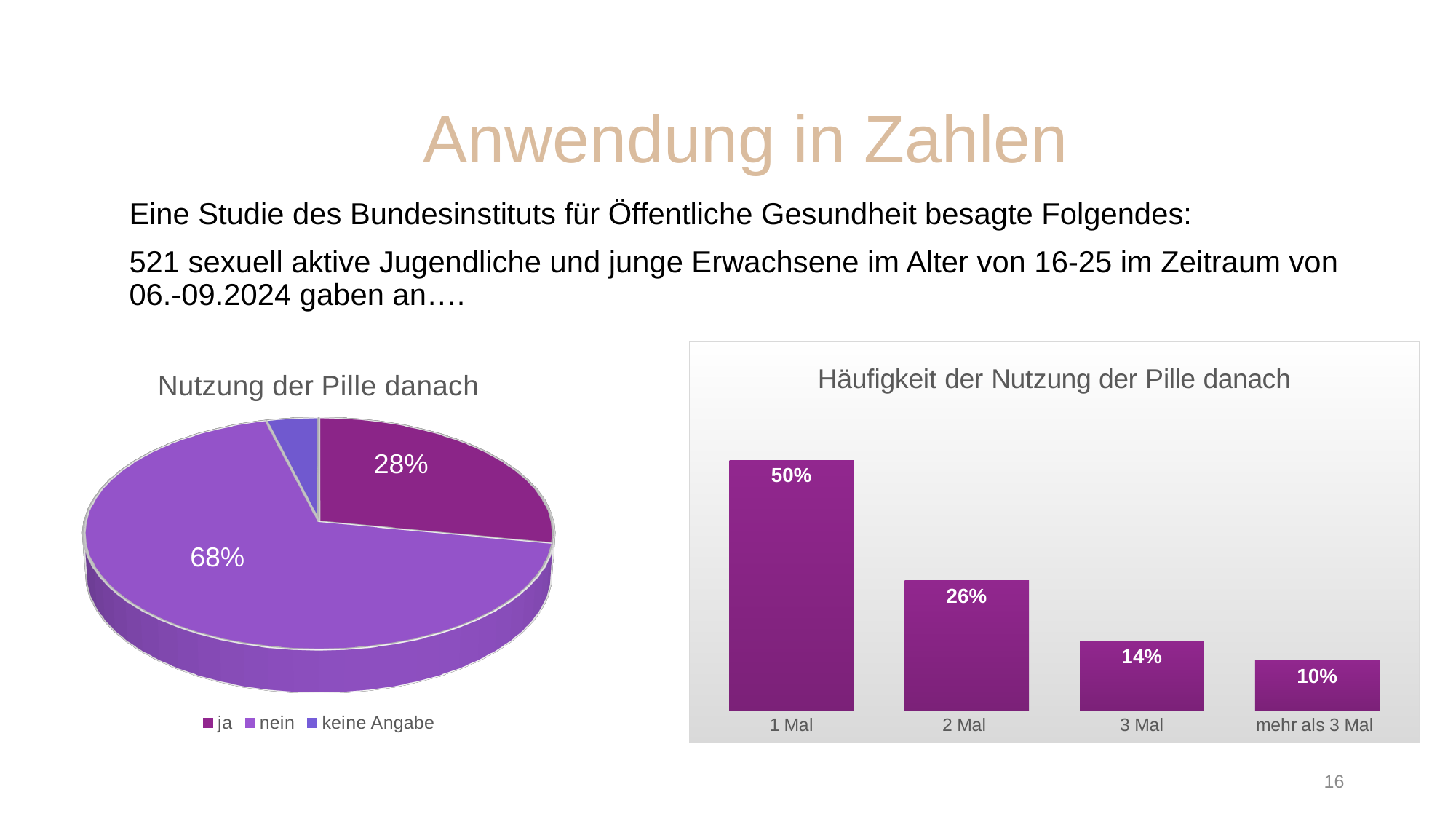
In the bar chart 'Häufigkeit der Nutzung der Pille danach', what is the difference in percentage points between '2 Mal' and '3 Mal'? 12 In the bar chart 'Häufigkeit der Nutzung der Pille danach', what is the value for 'mehr als 3 Mal'? 10% In the pie chart 'Nutzung der Pille danach', which category has the smallest slice? keine Angabe In the pie chart 'Nutzung der Pille danach', what percentage is shown for 'nein'? 68% In the pie chart 'Nutzung der Pille danach', what is the difference in percentage points between 'nein' and 'ja'? 40 What kind of chart is the one on the right side of the slide? bar chart In the bar chart 'Häufigkeit der Nutzung der Pille danach', which category has the lowest value? mehr als 3 Mal In the pie chart 'Nutzung der Pille danach', what percentage is shown for 'ja'? 28% In the bar chart 'Häufigkeit der Nutzung der Pille danach', what is the value for '1 Mal'? 50% In the pie chart 'Nutzung der Pille danach', how many categories does the legend list? 3 In the bar chart 'Häufigkeit der Nutzung der Pille danach', do the values rise or fall from left to right? fall In the pie chart 'Nutzung der Pille danach', which category has the largest slice? nein